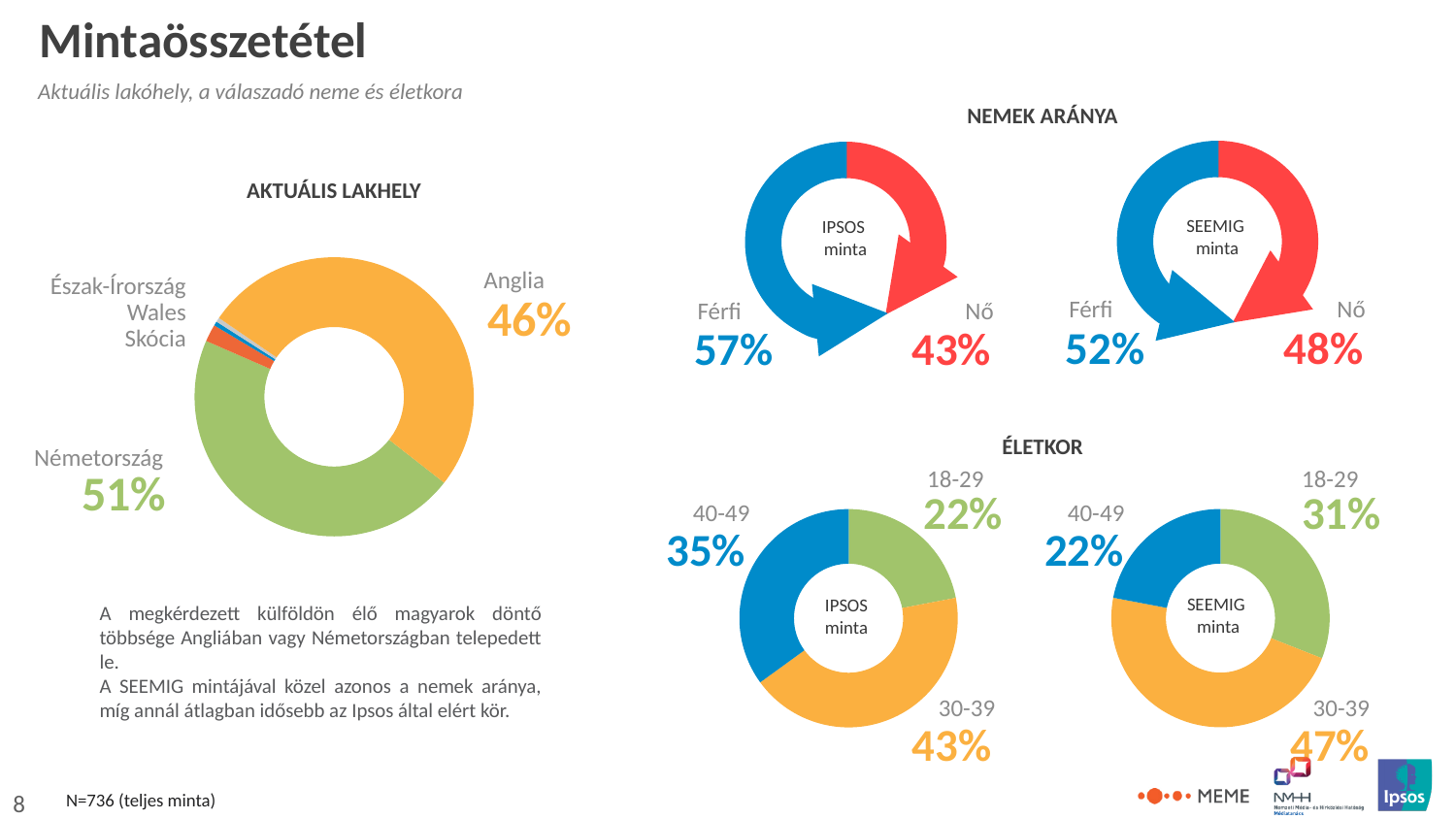
In the AKTUÁLIS LAKHELY chart, what share of respondents live in Anglia? 46% In the NEMEK ARÁNYA SEEMIG minta chart, what is the share of Nő? 48% In the AKTUÁLIS LAKHELY chart, which labelled country has the largest share? Németország What type of chart is used for the ÉLETKOR IPSOS minta data? Donut (pie) chart In the ÉLETKOR IPSOS minta chart, which age group has the smallest share? 18-29 In the NEMEK ARÁNYA IPSOS minta chart, what is the share of Férfi? 57% In the ÉLETKOR SEEMIG minta chart, what is the difference between the 30-39 and 40-49 shares? 25% In the NEMEK ARÁNYA charts, which sample has the larger share of Férfi, IPSOS minta or SEEMIG minta? IPSOS minta In the AKTUÁLIS LAKHELY chart, what is the difference between the Németország and Anglia shares? 5% In the ÉLETKOR IPSOS minta chart, what is the share of the 30-39 age group? 43% In the ÉLETKOR SEEMIG minta chart, what is the share of the 18-29 age group? 31% In the AKTUÁLIS LAKHELY chart, what share of respondents live in Németország? 51%